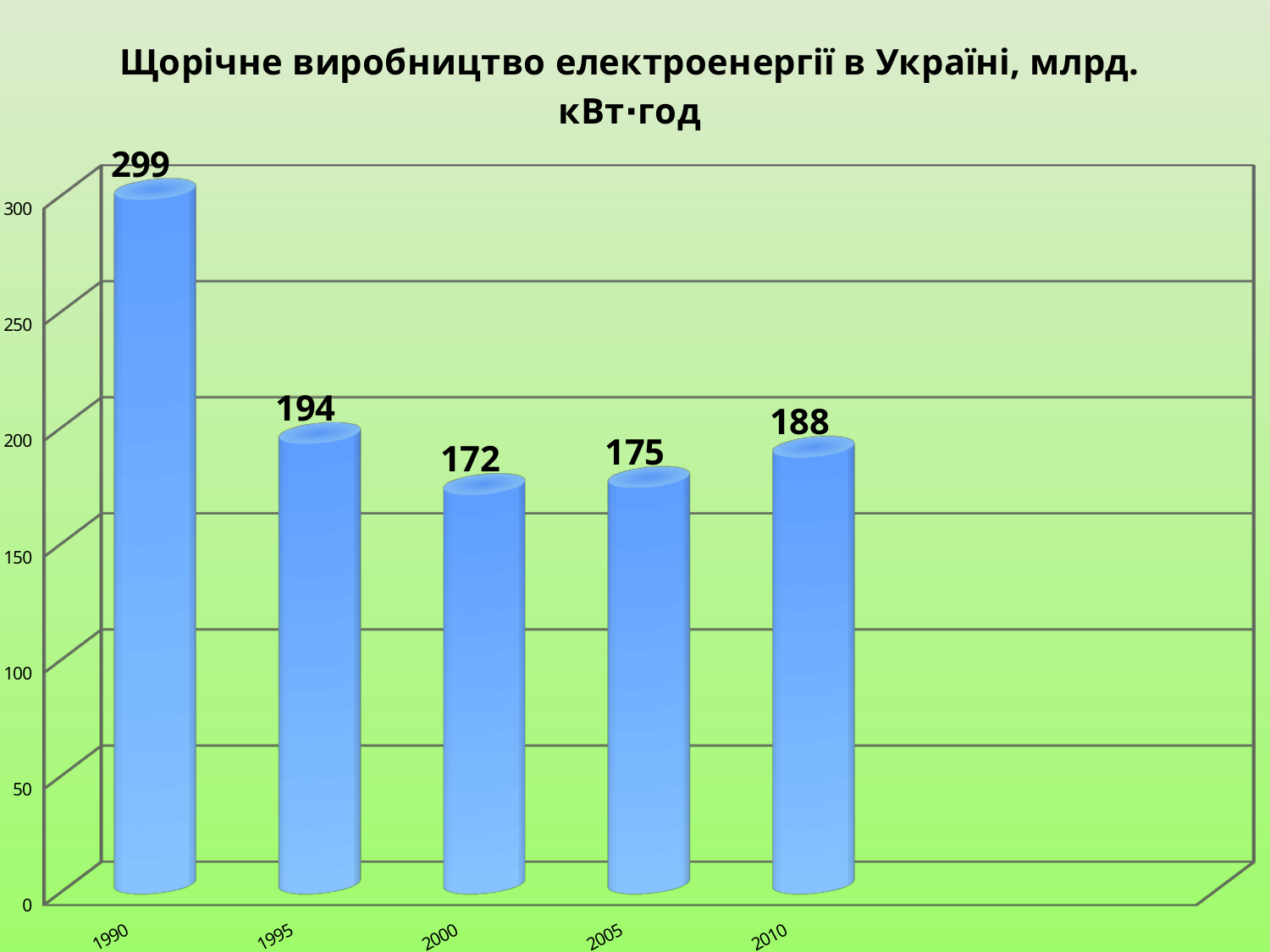
Which is larger, the value for 1995 or the value for 2010? 1995 What is the difference between the values for 1990 and 1995? 105 What is the value for 2000? 172 Which year has the lowest value? 2000 How many years are shown on the chart? 5 Which year has the highest value? 1990 What is the difference between the values for 2010 and 2005? 13 What is the title of the chart? Щорічне виробництво електроенергії в Україні, млрд. кВт·год What is the value for 1990? 299 Is the value for 2005 greater or less than 200? less What is the value for 2010? 188 What kind of chart is this? bar chart